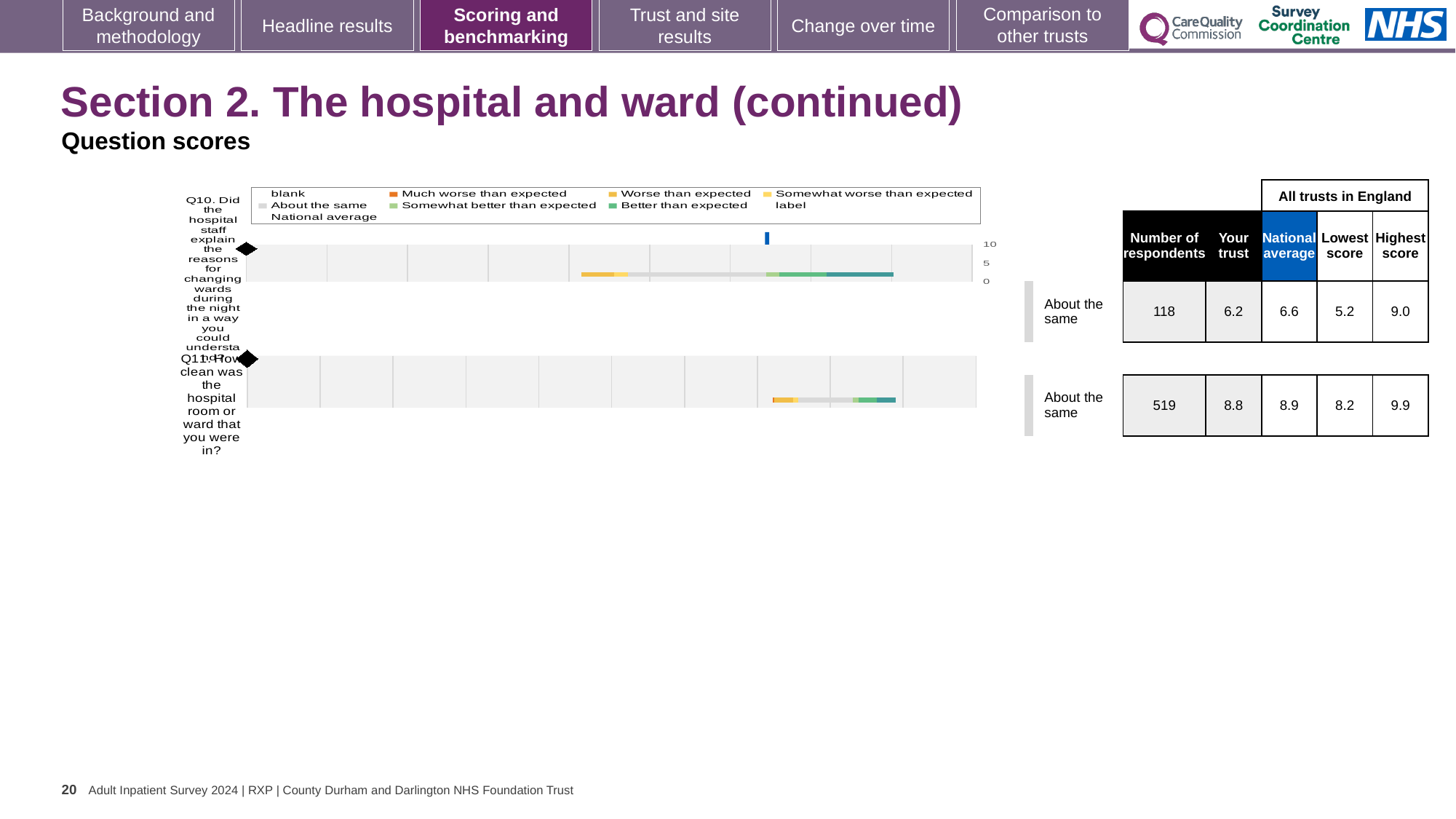
What kind of chart is used to show the question scores on this slide? bar chart According to the label beside the Q10 chart, which benchmark category does the trust's Q10 score fall into? About the same Which question has the higher 'Your trust' score in the tables, Q10 or Q11? Q11 What is the difference between the highest score and the lowest score for Q10 in the table? 3.8 In the table beside the Q11 chart, what is the national average score? 8.9 Which survey question does the top chart relate to? Q10 What colour represents 'Much worse than expected' in the chart legend? orange What is the highest tick value shown on the chart axis? 10 In the table beside the Q10 chart, what is the 'Your trust' score? 6.2 In the table beside the Q11 chart, how many respondents answered Q11? 519 According to the label beside the Q11 chart, which benchmark category does the trust's Q11 score fall into? About the same How many survey questions have a benchmarking chart on this slide? 2